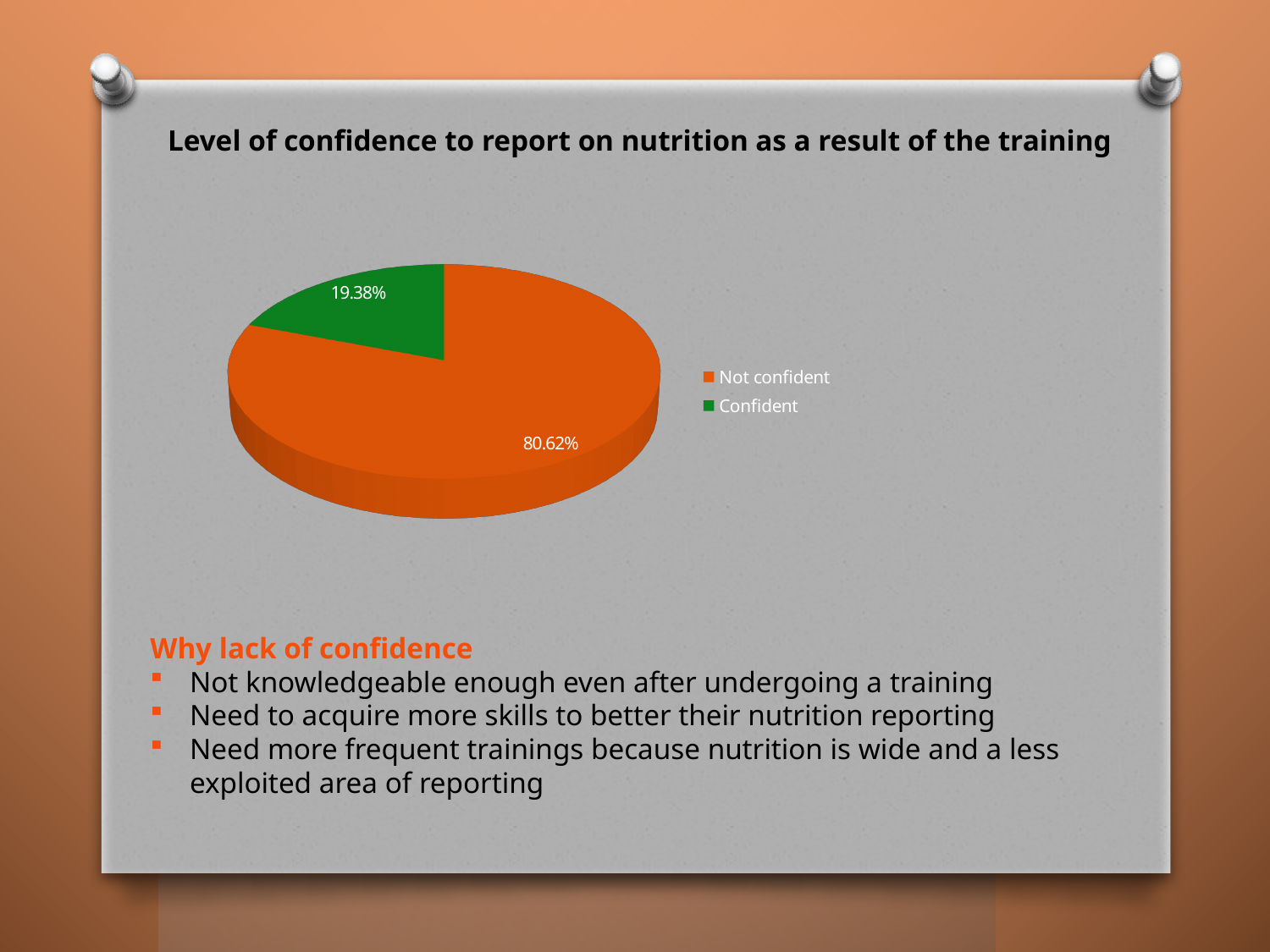
Which is larger, the Confident slice or the Not confident slice? Not confident What is the difference in percentage points between the Not confident and Confident slices? 61.24 Which category has the largest share of the pie? Not confident What share of the pie does the Not confident slice represent? 80.62% What percentage of respondents were confident? 19.38% How many slices does the pie chart have? 2 What percentage of respondents were not confident? 80.62% Which category has the smallest share of the pie? Confident What colour is the Confident slice? Green How many entries does the legend list? 2 What kind of chart is shown on the slide? Pie chart What is the title of the chart? Level of confidence to report on nutrition as a result of the training